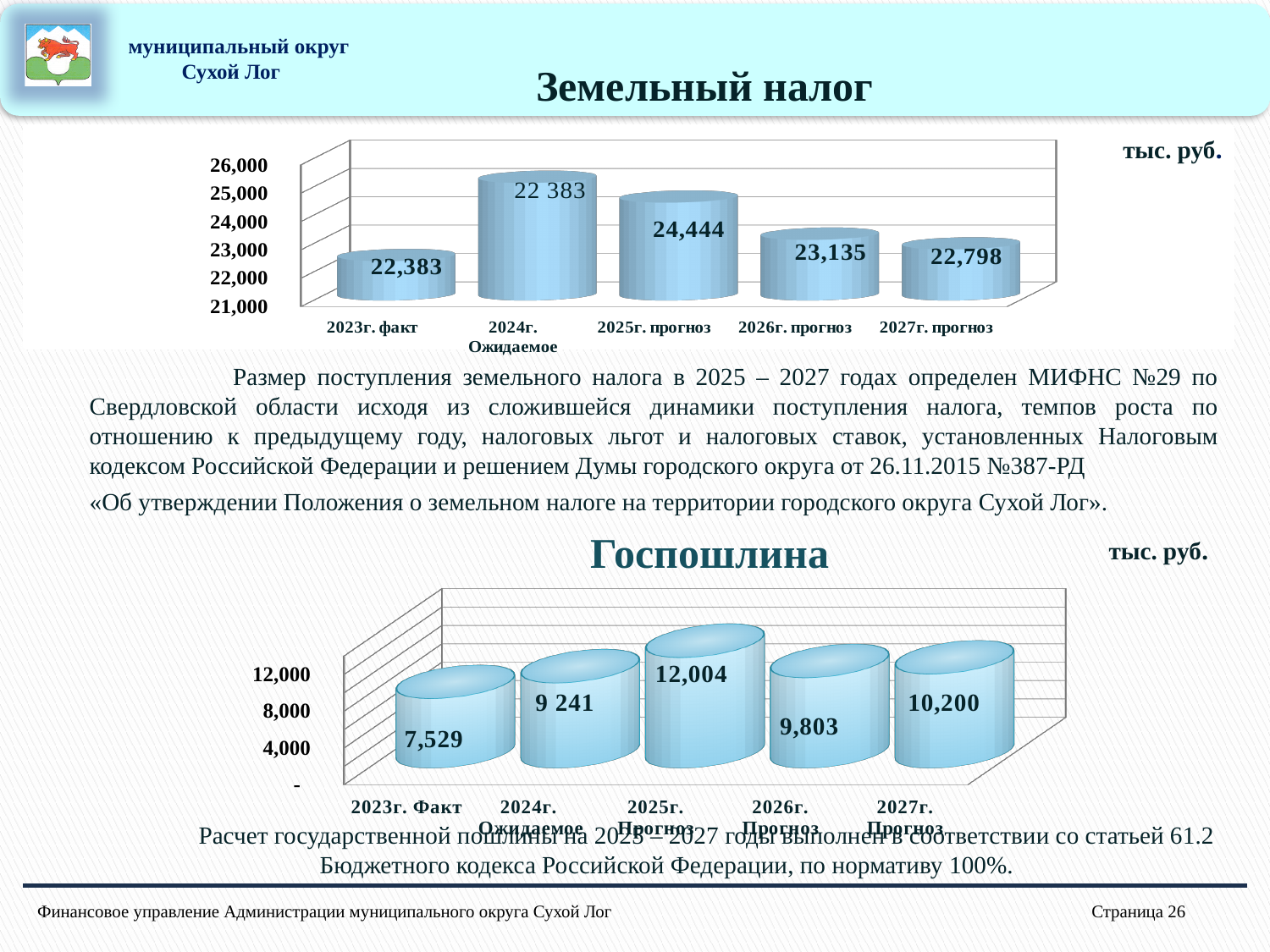
In the Госпошлина chart, which category has the lowest value? 2023г. Факт In the Госпошлина chart, which category has the highest value? 2025г. Прогноз In the Земельный налог chart, what is the value for 2027г. прогноз? 22,798 In the Госпошлина chart, is the value for 2027г. Прогноз greater or less than 8,000? greater In the Земельный налог chart, what is the value for 2025г. прогноз? 24,444 What kind of chart is the Госпошлина chart? bar chart How many categories are shown in the Земельный налог chart? 5 In the Земельный налог chart, which is larger: the value for 2026г. прогноз or 2027г. прогноз? 2026г. прогноз In the Госпошлина chart, what is the value for 2026г. Прогноз? 9,803 In the Госпошлина chart, what is the value for 2023г. Факт? 7,529 In the Госпошлина chart, what is the difference between the values for 2025г. Прогноз and 2023г. Факт? 4,475 In the Земельный налог chart, what is the difference between the values for 2025г. прогноз and 2026г. прогноз? 1,309